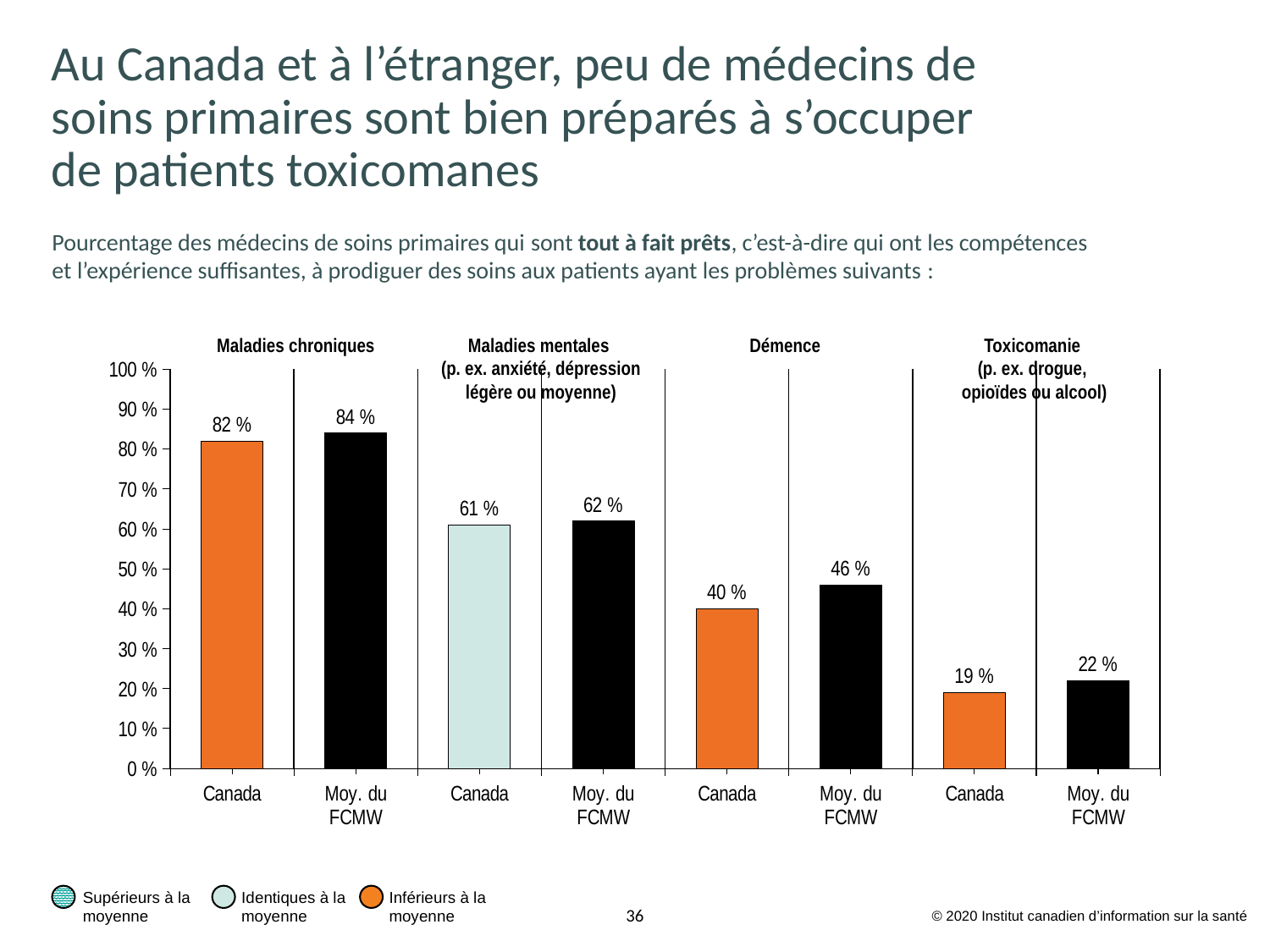
What is the value for Canada under Maladies chroniques? 82 % Which bar is coloured light blue-green, indicating 'Identiques à la moyenne'? Canada, Maladies mentales What is the value for Canada under Démence? 40 % Which bar has the lowest value on the chart? Canada, Toxicomanie What is the difference between Moy. du FCMW and Canada under Toxicomanie? 3 % How many bars are plotted on the chart? 8 What is the value for Moy. du FCMW under Toxicomanie? 22 % Which is larger: Canada under Maladies mentales or Canada under Démence? Canada under Maladies mentales What is the value for Moy. du FCMW under Maladies mentales? 62 % What is the difference between Moy. du FCMW and Canada under Démence? 6 % Which bar has the highest value on the chart? Moy. du FCMW, Maladies chroniques What kind of chart is shown on the slide? Bar chart